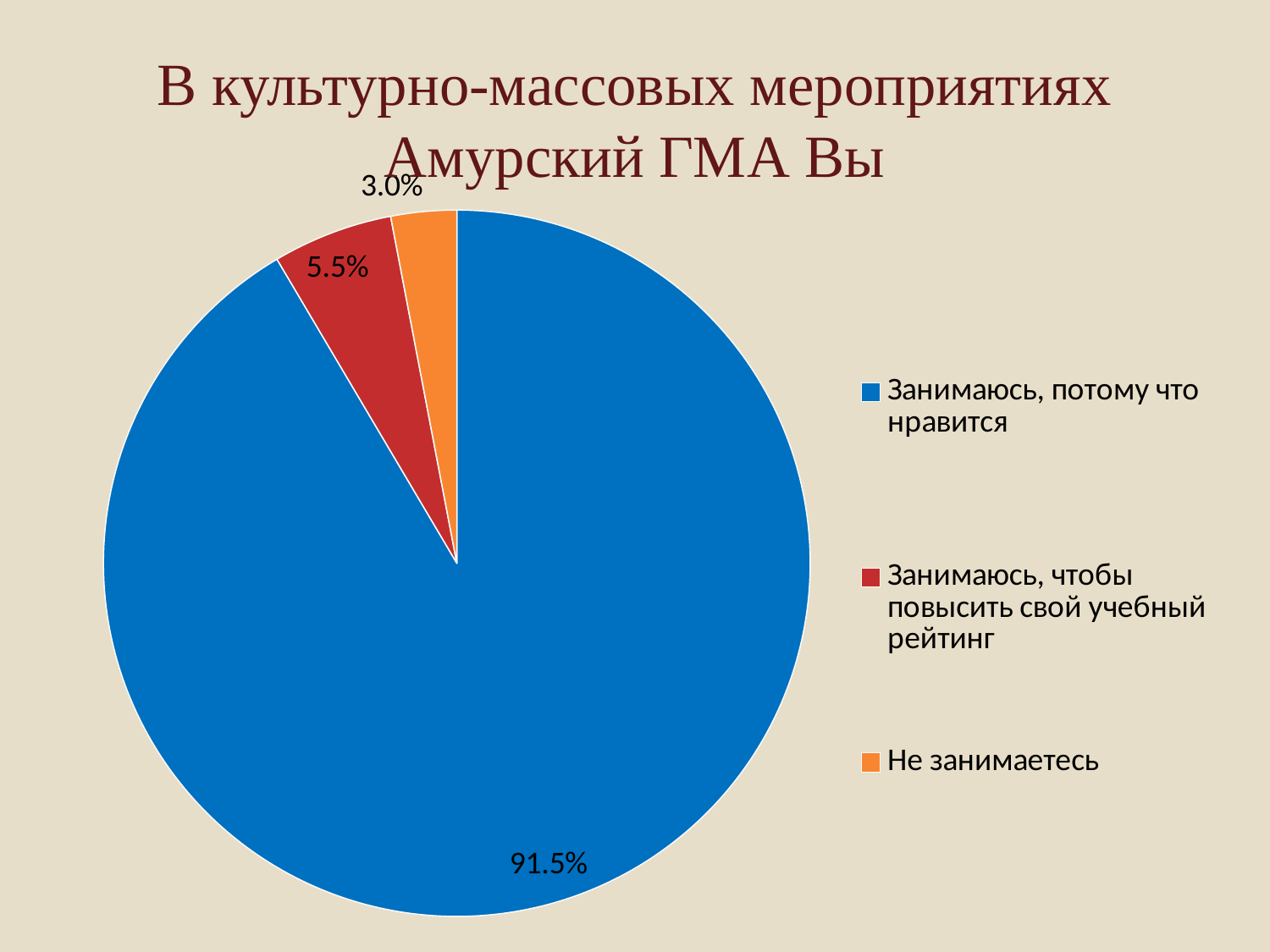
What share of the pie is labelled "Занимаюсь, потому что нравится"? 91.5% What is the difference between the shares for "Занимаюсь, чтобы повысить свой учебный рейтинг" and "Не занимаетесь"? 2.5% What share of the pie is labelled "Занимаюсь, чтобы повысить свой учебный рейтинг"? 5.5% What kind of chart is shown on the slide? pie chart Which category has the largest slice of the pie? Занимаюсь, потому что нравится What colour is the slice for "Не занимаетесь"? orange Which is larger: the slice for "Занимаюсь, чтобы повысить свой учебный рейтинг" or the slice for "Не занимаетесь"? Занимаюсь, чтобы повысить свой учебный рейтинг How many slices does the pie chart have? 3 Which category has the smallest slice of the pie? Не занимаетесь How many entries does the legend list? 3 What share of the pie is labelled "Не занимаетесь"? 3.0% What is the difference between the shares for "Занимаюсь, потому что нравится" and "Занимаюсь, чтобы повысить свой учебный рейтинг"? 86.0%